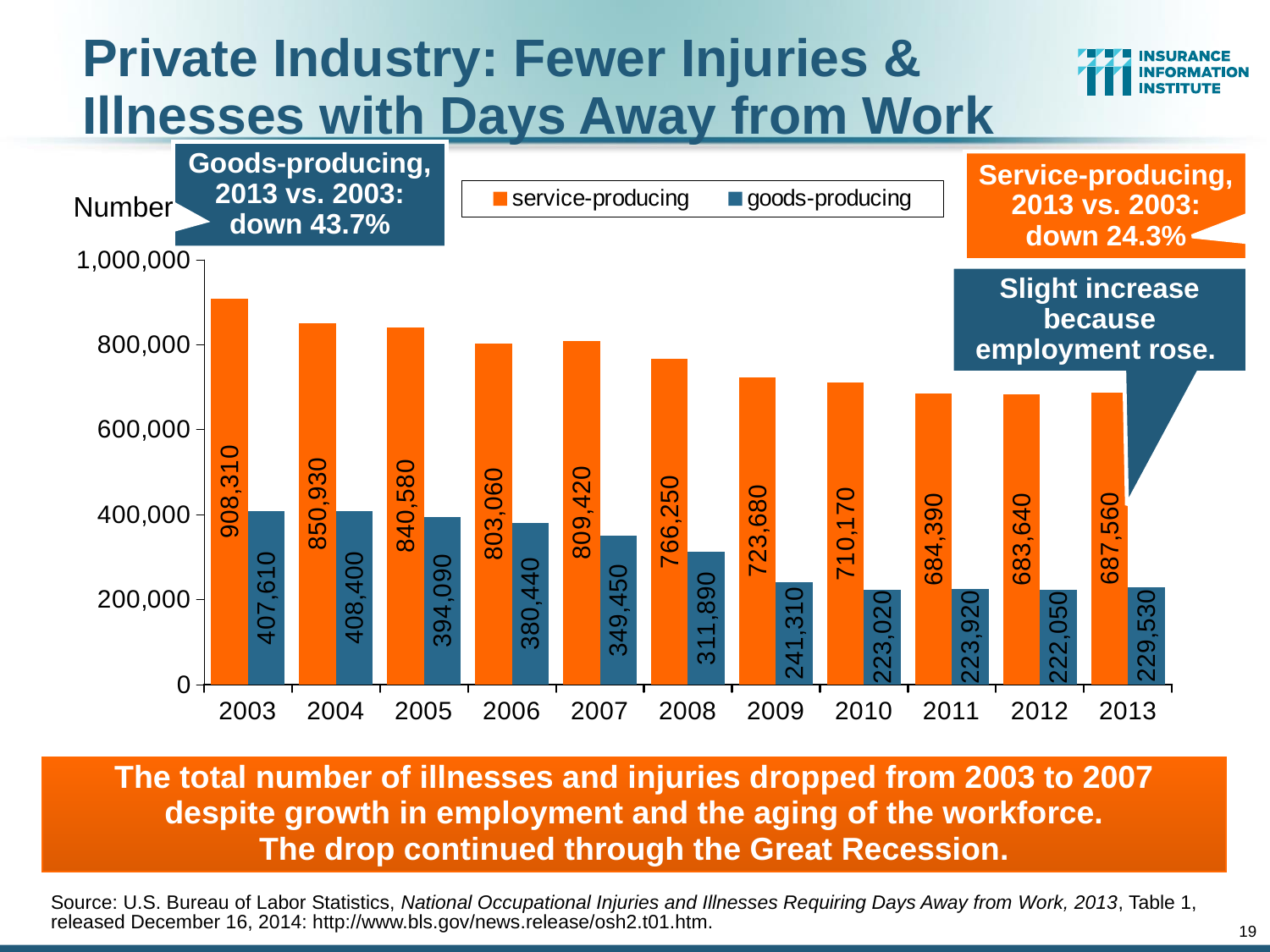
Do the goods-producing values generally rise or fall from 2003 to 2013? fall How many series does the legend list? 2 What is the difference between the service-producing values for 2003 and 2013? 220,750 What is the value for goods-producing in 2009? 241,310 What is the value for service-producing in 2003? 908,310 Is the service-producing value for 2013 greater or less than 600,000? greater What kind of chart is shown on the slide? bar chart In which year is the service-producing value highest? 2003 What is the difference between the goods-producing values for 2003 and 2013? 178,080 In 2008, which is larger: service-producing or goods-producing? service-producing What is the value for goods-producing in 2013? 229,530 How many years are shown on the x axis? 11